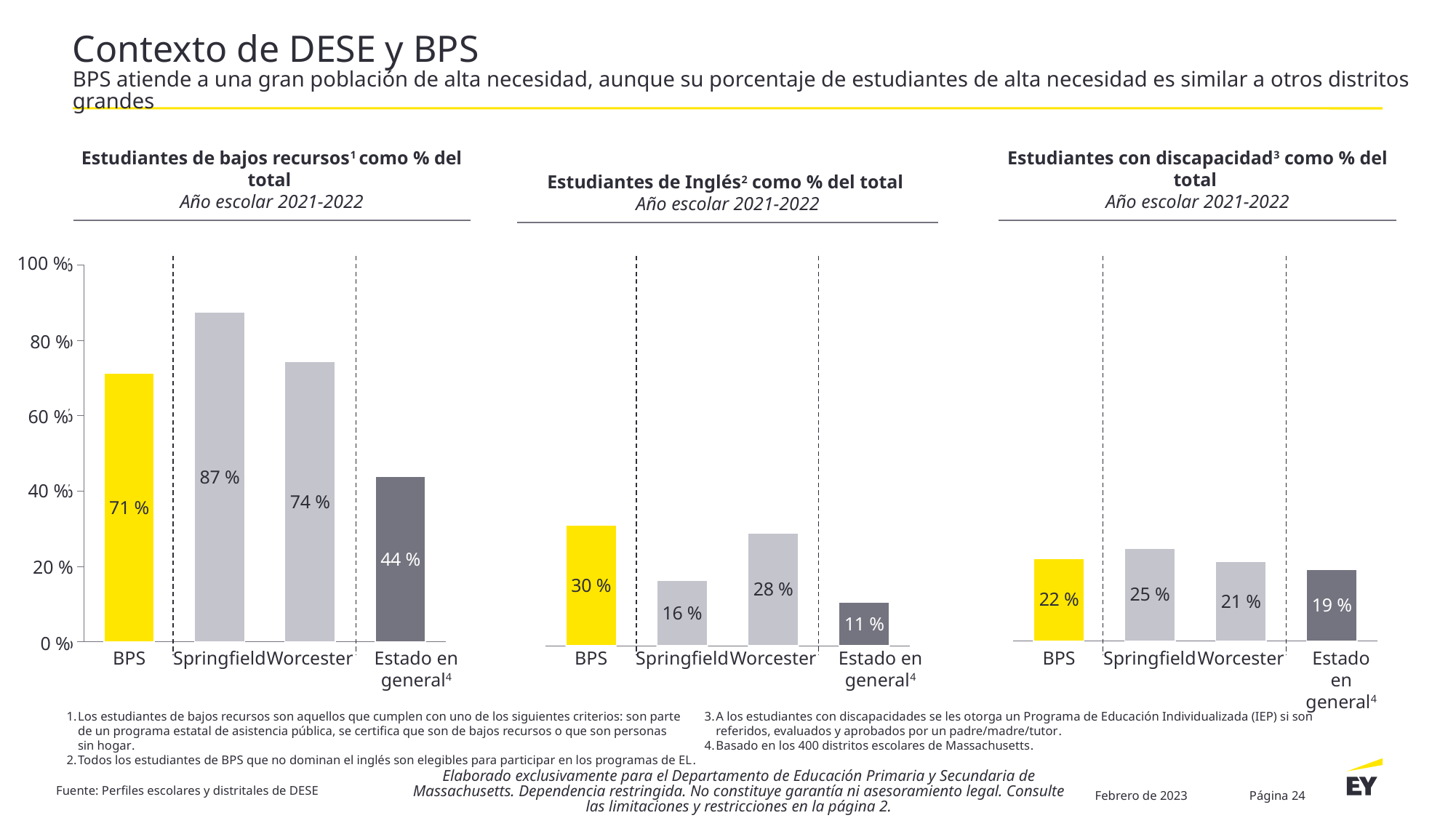
In the 'Estudiantes de bajos recursos como % del total' chart, which category has the highest value? Springfield In the 'Estudiantes de bajos recursos como % del total' chart, what is the value for BPS? 71 % In the 'Estudiantes con discapacidad como % del total' chart, what is the value for Springfield? 25 % In the 'Estudiantes de Inglés como % del total' chart, which category has the lowest value? Estado en general In the 'Estudiantes con discapacidad como % del total' chart, which category has the highest value? Springfield In the 'Estudiantes de Inglés como % del total' chart, what is the value for Worcester? 28 % What type of chart is the 'Estudiantes de bajos recursos como % del total' chart? Bar chart How many categories are shown in the 'Estudiantes de Inglés como % del total' chart? 4 In the 'Estudiantes de Inglés como % del total' chart, which is larger, BPS or Springfield? BPS Which school year do the three charts on the slide cover? Año escolar 2021-2022 In the 'Estudiantes con discapacidad como % del total' chart, what is the difference between BPS and Estado en general? 3 % In the 'Estudiantes de bajos recursos como % del total' chart, what is the difference between Springfield and Estado en general? 43 %